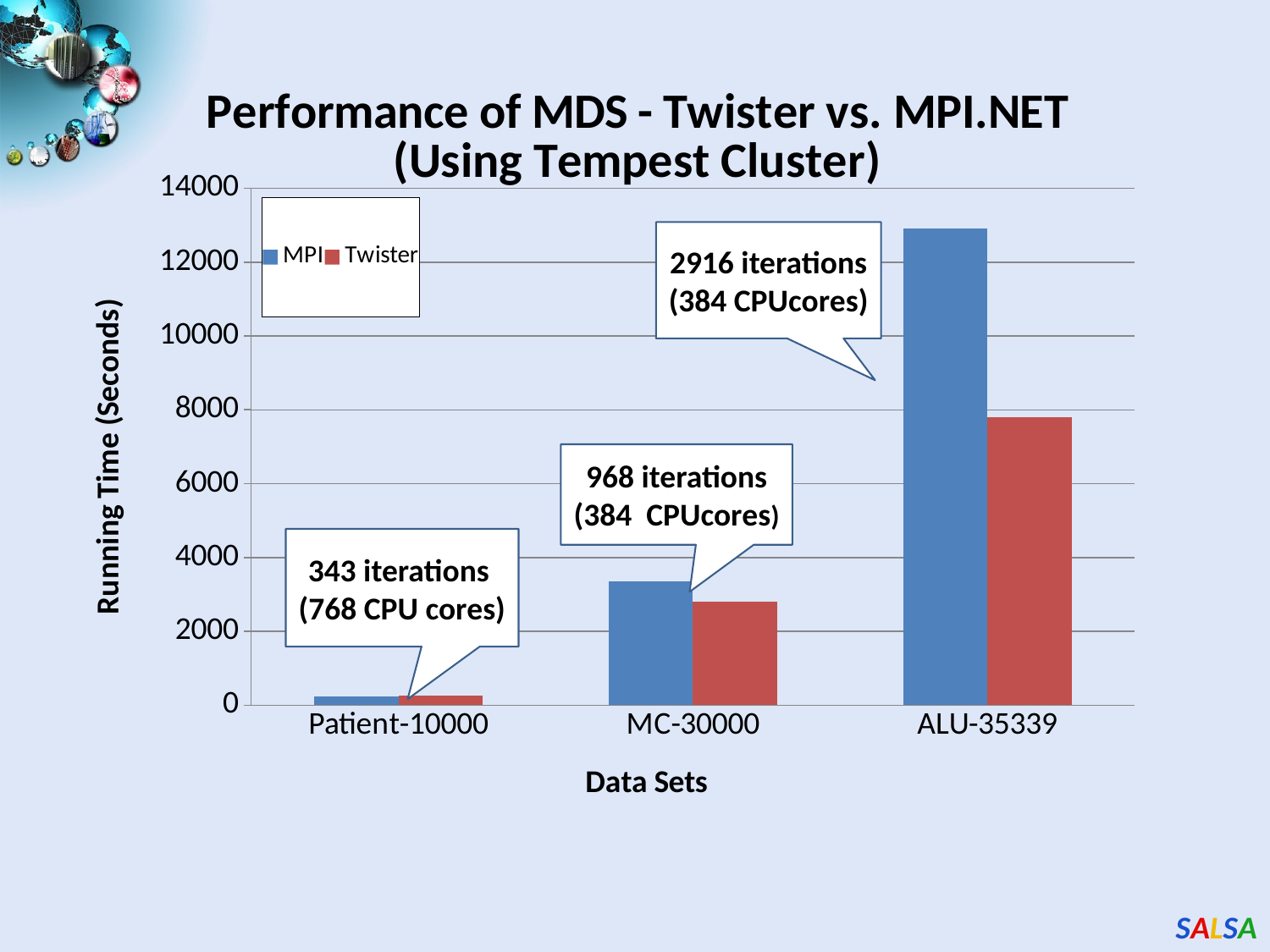
Is the MPI running time for ALU-35339 greater or less than 12000? greater For ALU-35339, which series has the larger running time, MPI or Twister? MPI How many series does the legend list? 2 What is the label of the y axis? Running Time (Seconds) How many data sets (categories) are shown on the x axis? 3 For MC-30000, which series has the larger running time, MPI or Twister? MPI Which data set has the highest MPI running time? ALU-35339 Is the Twister running time for ALU-35339 greater or less than 6000? greater What kind of chart is shown on the slide? Bar chart Do the MPI running times rise or fall moving from Patient-10000 to ALU-35339 along the x axis? rise Is the MPI running time for MC-30000 greater or less than 4000? less Which data set has the lowest Twister running time? Patient-10000